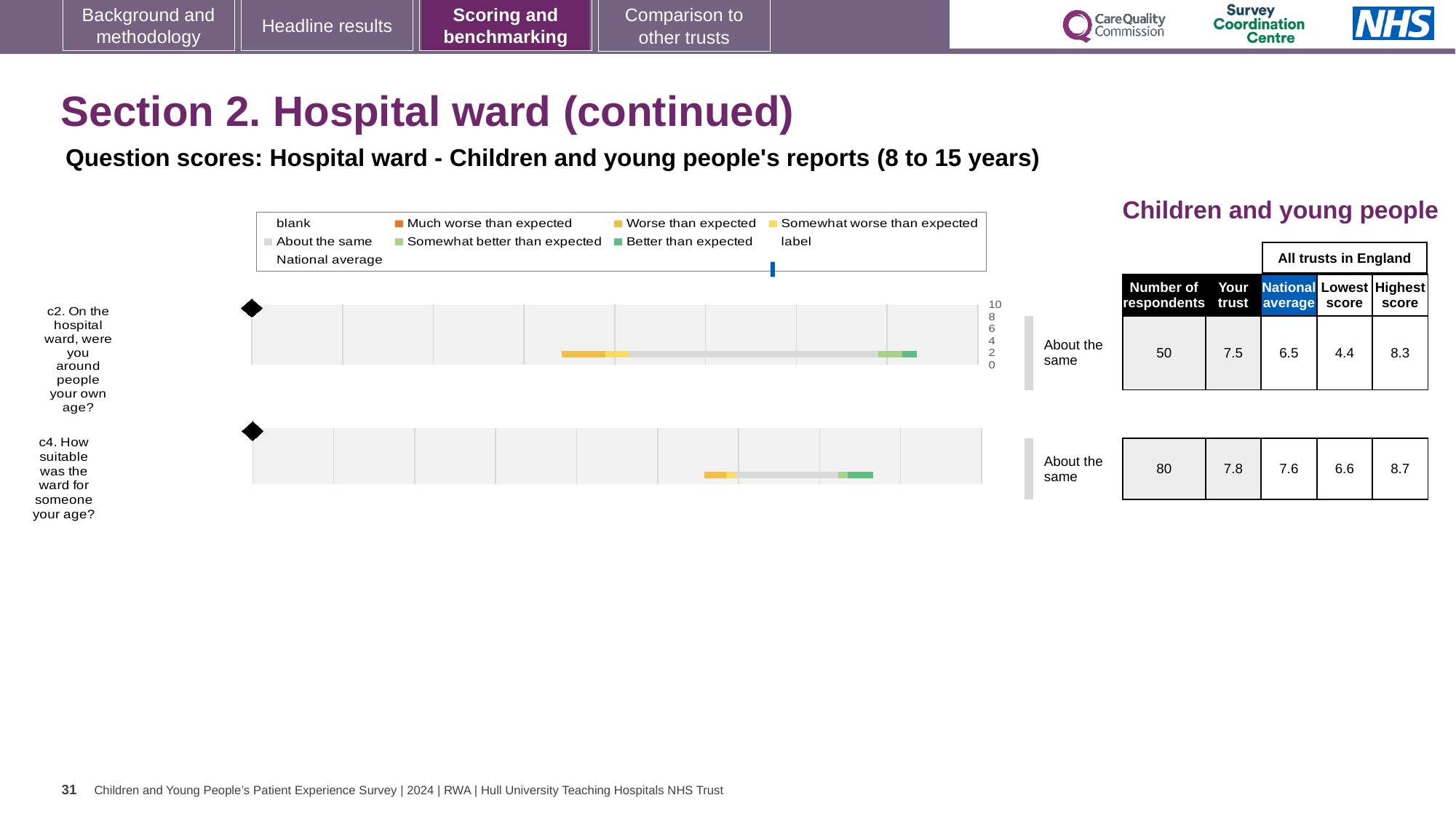
What is the national average score shown for c2? 6.5 What is the number of respondents shown for c4? 80 Which question has the higher 'Your trust' score, c2 or c4? c4 Which legend entry is shown in dark green? Better than expected What is the difference between the 'Your trust' score and the national average for c2? 1.0 What is the highest score across all trusts in England for c4? 8.7 How many questions (categories) are plotted on the slide? 2 According to the table, what is the 'Your trust' score for c4 (How suitable was the ward for someone your age?)? 7.8 What is the difference between the highest score and the lowest score for c2? 3.9 What type of chart is used to show the question scores on this slide? bar chart According to the table, what is the 'Your trust' score for c2 (On the hospital ward, were you around people your own age?)? 7.5 What benchmark rating is shown next to both c2 and c4? About the same